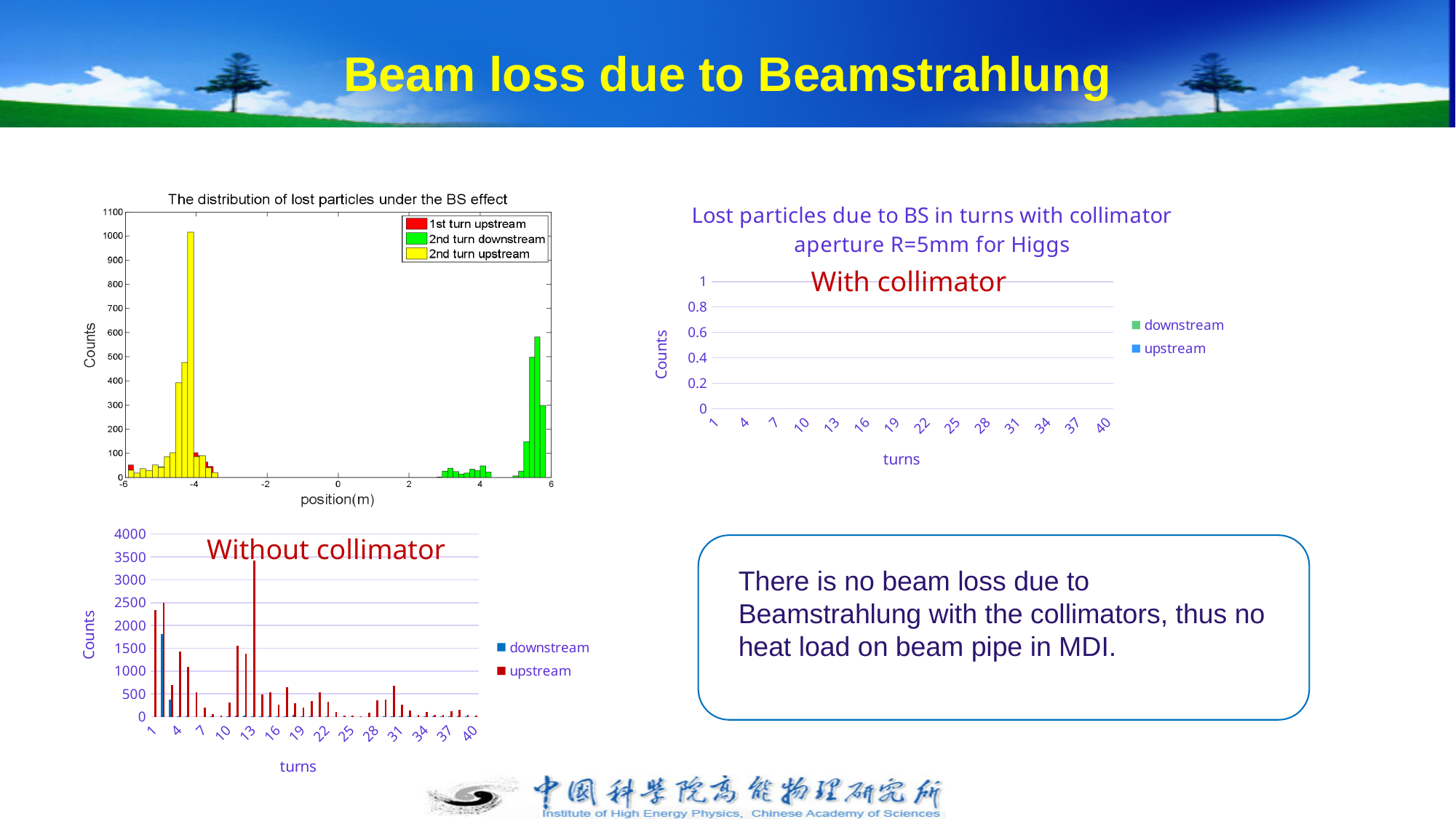
In the 'Without collimator' chart, is the upstream value at turn 1 greater or less than 2000? greater In the chart titled 'The distribution of lost particles under the BS effect', which colour represents '2nd turn upstream'? Yellow What kind of chart is the 'With collimator' chart? Bar chart In the 'Without collimator' chart, at which turn is the upstream count highest? 13 How many series does the legend of the 'With collimator' chart list? 2 In the 'Without collimator' chart, is the upstream value at turn 13 greater or less than 3000? greater How many series does the legend of the chart titled 'The distribution of lost particles under the BS effect' list? 3 In the 'Without collimator' chart, which is larger: the upstream value at turn 2 or the upstream value at turn 5? Turn 2 In the chart titled 'The distribution of lost particles under the BS effect', is the tallest yellow bar greater or less than 900 counts? greater What is the x-axis label of the chart titled 'The distribution of lost particles under the BS effect'? position(m) What is the highest value shown on the y-axis of the 'With collimator' chart? 1